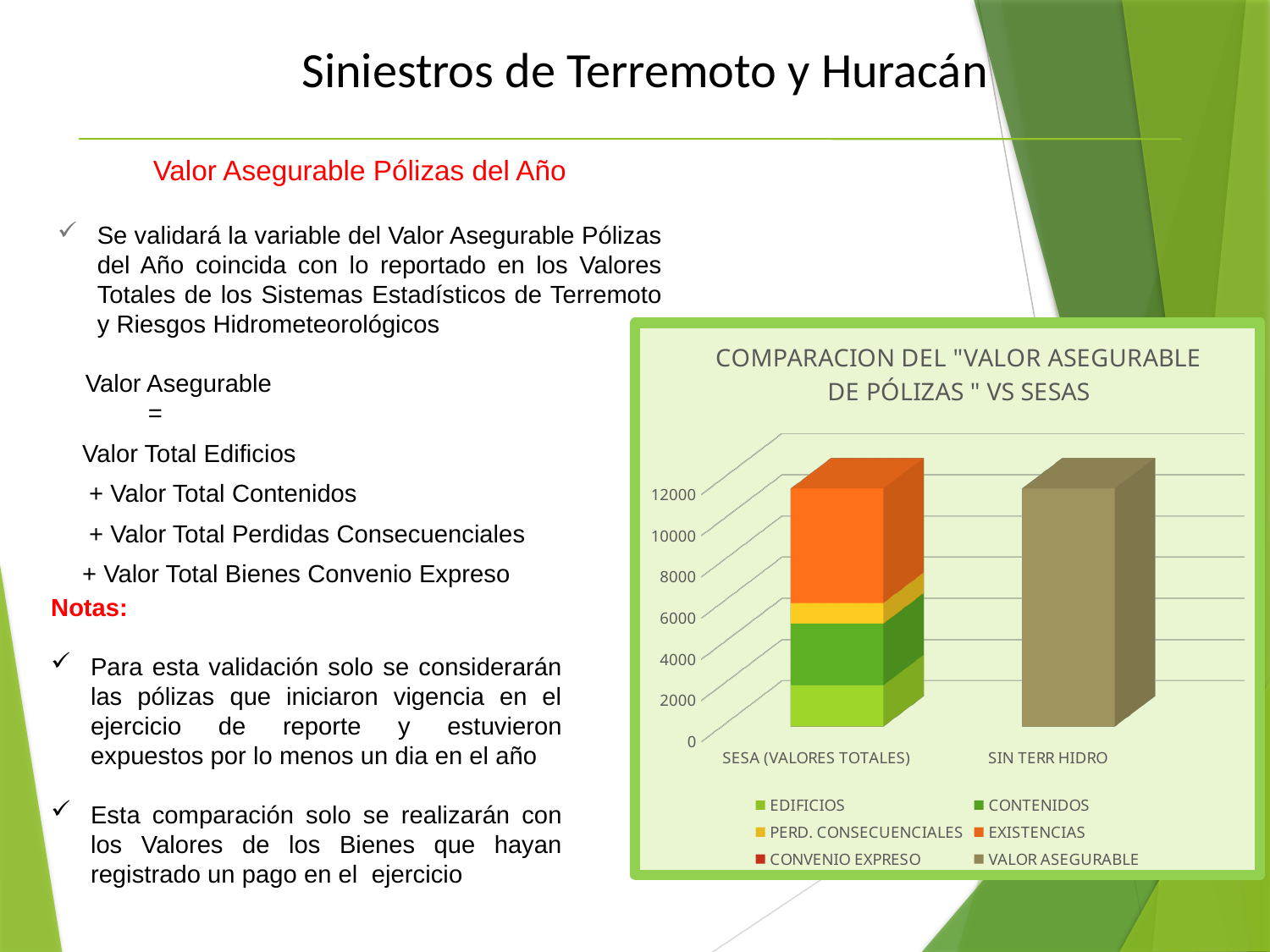
What is the highest value shown on the vertical axis of the chart? 12000 What type of chart is shown on the slide? stacked bar chart How many categories are shown on the x axis of the chart? 2 How many series does the chart legend list? 6 Which series makes up the SIN TERR HIDRO bar? VALOR ASEGURABLE Is the EDIFICIOS segment of the SESA (VALORES TOTALES) bar greater or less than 4000? less Which series is shown in orange in the chart legend? EXISTENCIAS What is the title of the chart? COMPARACION DEL "VALOR ASEGURABLE DE PÓLIZAS " VS SESAS Is the value of the SIN TERR HIDRO bar greater or less than 10000? greater Which series makes up the largest segment of the SESA (VALORES TOTALES) bar? EXISTENCIAS Is the total value of the SESA (VALORES TOTALES) bar greater or less than 10000? greater